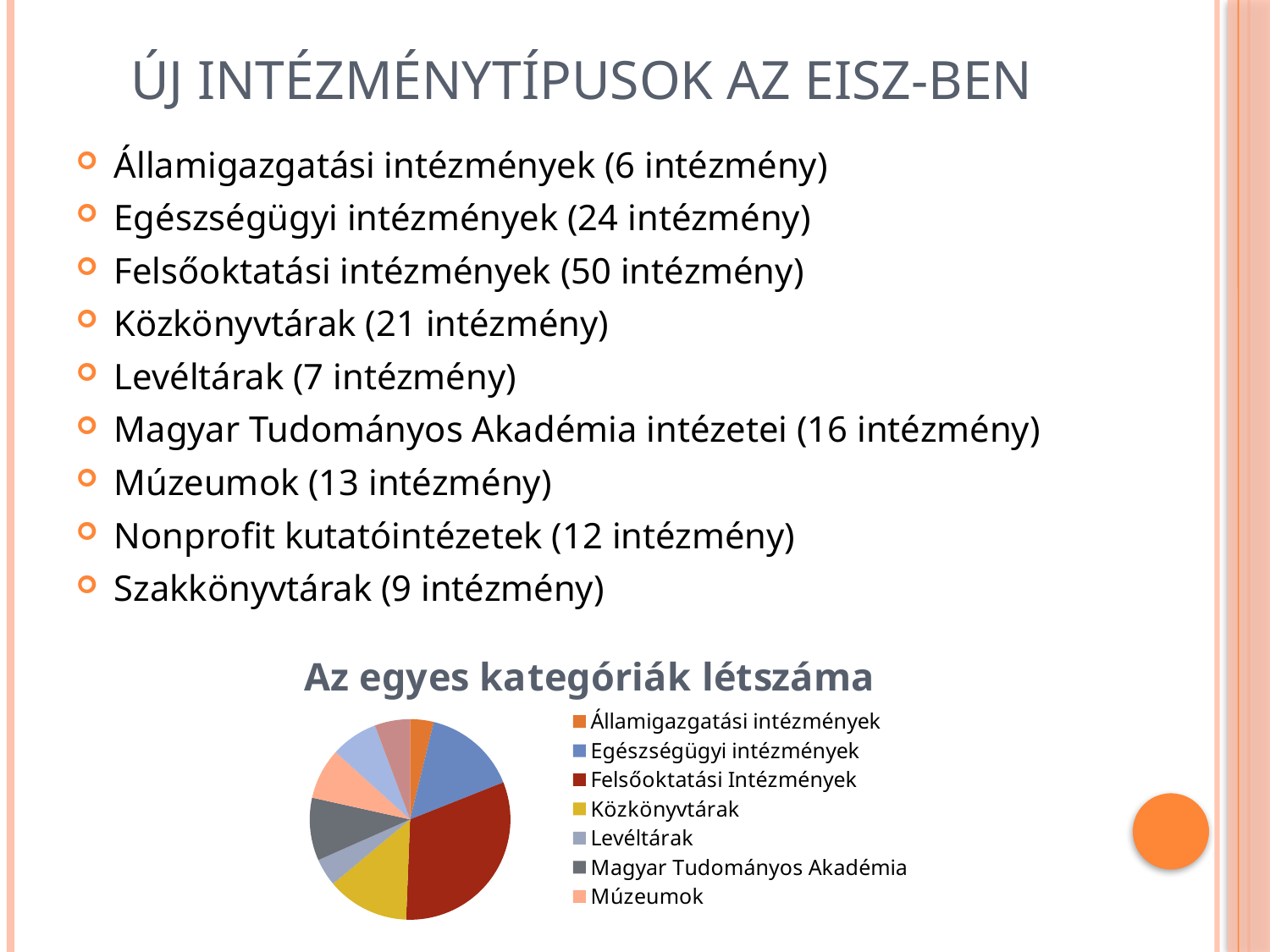
Which legend category has the smallest slice in the pie chart? Államigazgatási intézmények In the pie chart, which slice is larger: Közkönyvtárak or Levéltárak? Közkönyvtárak In the pie chart, which slice is larger: Magyar Tudományos Akadémia or Államigazgatási intézmények? Magyar Tudományos Akadémia How many slices does the pie chart have? 9 Which category has the largest slice in the pie chart? Felsőoktatási Intézmények What colour is the Felsőoktatási Intézmények slice in the pie chart? dark red How many entries does the legend of the pie chart list? 7 In the pie chart, which slice is larger: Felsőoktatási Intézmények or Egészségügyi intézmények? Felsőoktatási Intézmények What is the title of the chart on the slide? Az egyes kategóriák létszáma What kind of chart is shown under the heading "Az egyes kategóriák létszáma"? pie chart